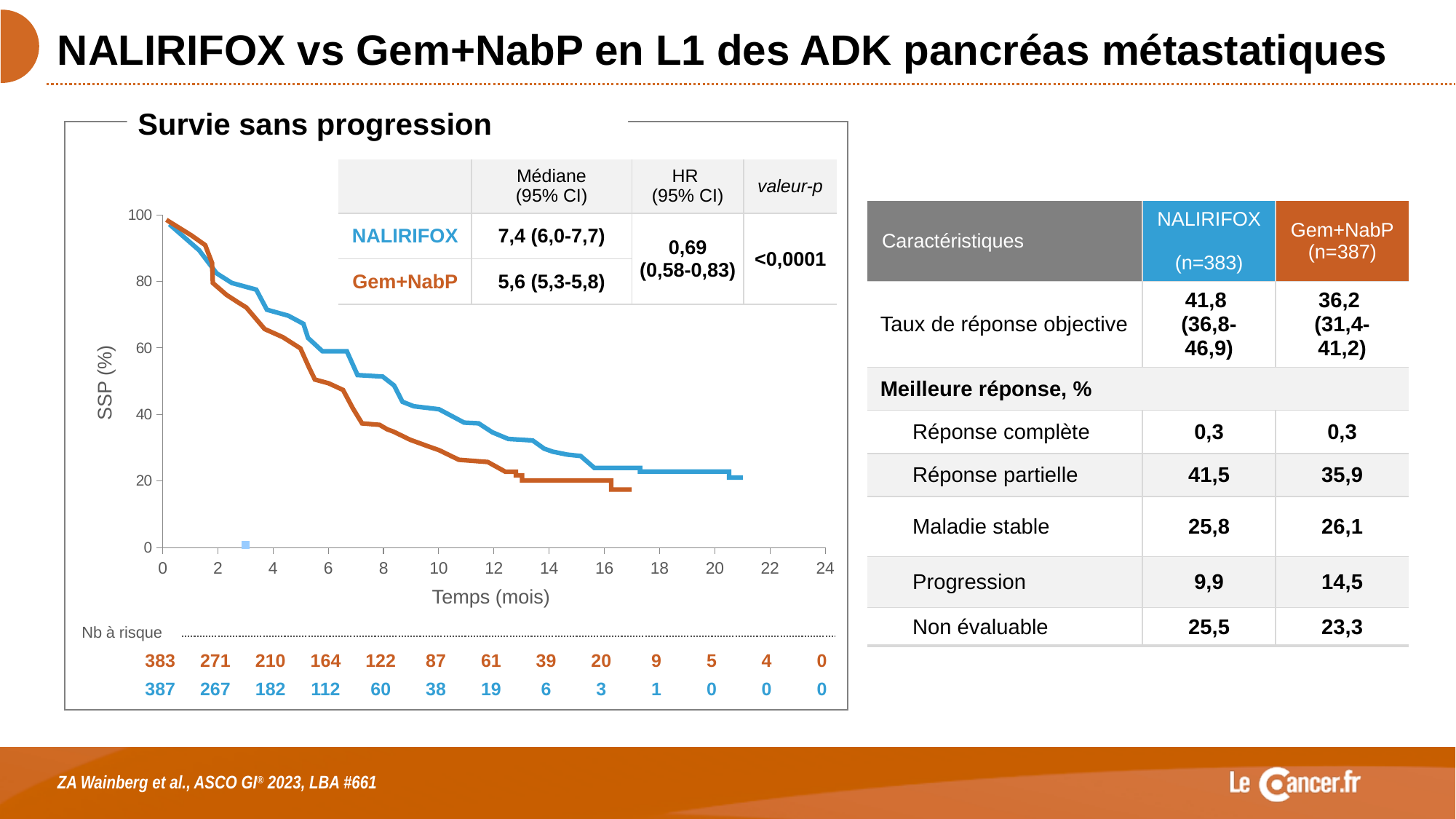
What kind of chart is shown under the title "Survie sans progression"? line chart How many treatment series are plotted on the "Survie sans progression" chart? 2 On the "Survie sans progression" chart, is the NALIRIFOX curve at 8 months greater or less than 40%? greater On the "Survie sans progression" chart, what is the median (95% CI) for Gem+NabP? 5,6 (5,3-5,8) On the "Survie sans progression" chart, do the curves rise or fall as time increases? fall On the "Survie sans progression" chart, what is the difference in median survival between NALIRIFOX and Gem+NabP? 1,8 On the "Survie sans progression" chart, what is the p-value shown in the inset table? <0,0001 On the "Survie sans progression" chart, what is the median (95% CI) for NALIRIFOX? 7,4 (6,0-7,7) On the "Survie sans progression" chart, is the Gem+NabP curve at 10 months greater or less than 40%? less On the "Survie sans progression" chart, what is the label of the x axis? Temps (mois) On the "Survie sans progression" chart, what is the HR (95% CI) shown in the inset table? 0,69 (0,58-0,83) On the "Survie sans progression" chart, which treatment has the higher median progression-free survival? NALIRIFOX